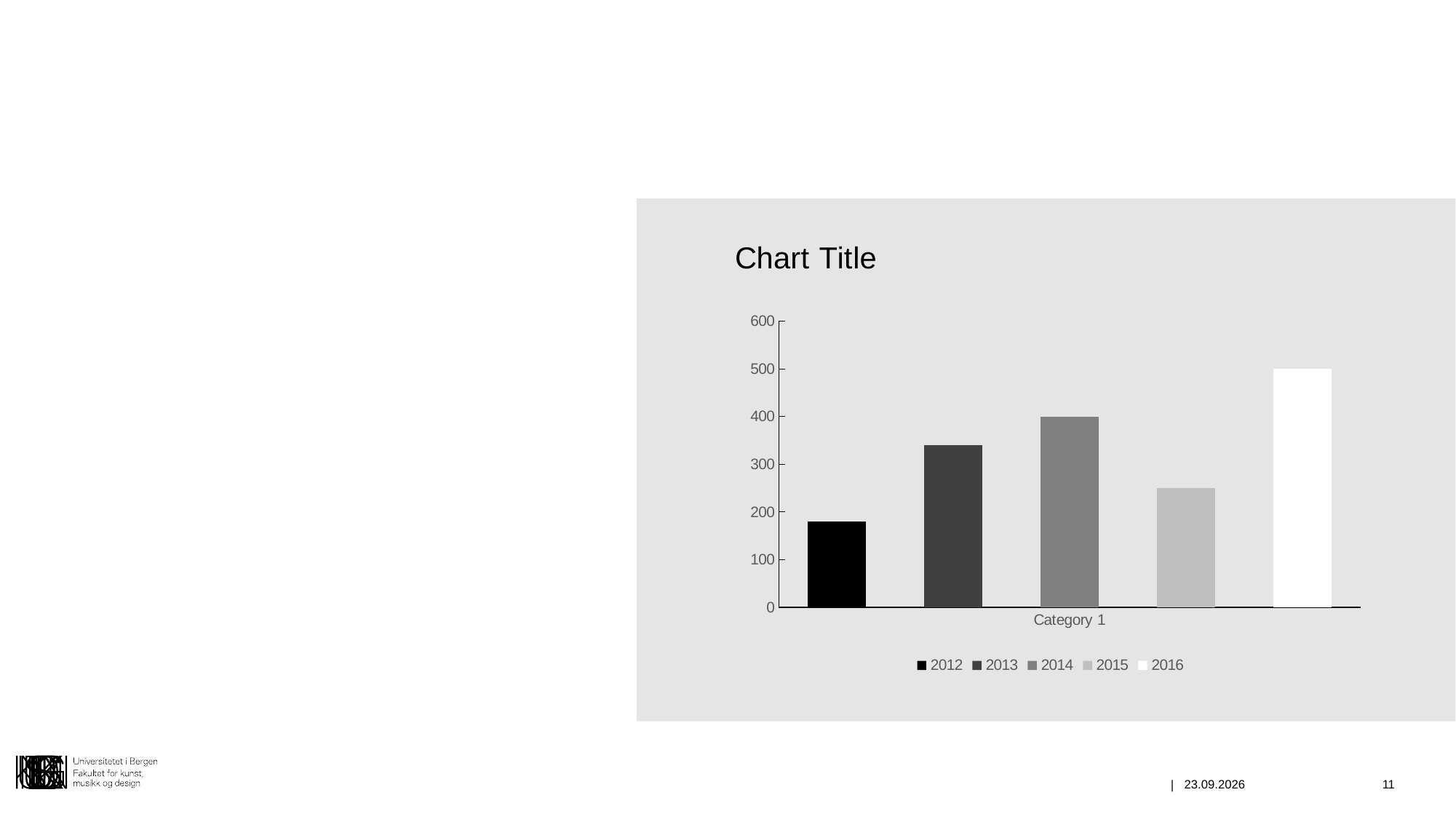
What is the value for 2016 in Category 1? 500 What kind of chart is shown on the slide? bar chart Is the value for 2013 greater or less than 300? greater Is the value for 2012 greater or less than 200? less How many series does the legend list? 5 Which is larger for Category 1, the value for 2013 or the value for 2015? 2013 What is the label of the category on the x axis? Category 1 Is the value for 2015 greater or less than 300? less Which series has the highest bar for Category 1? 2016 What is the title of the chart? Chart Title How many categories are shown on the x axis? 1 Which series has the lowest bar for Category 1? 2012